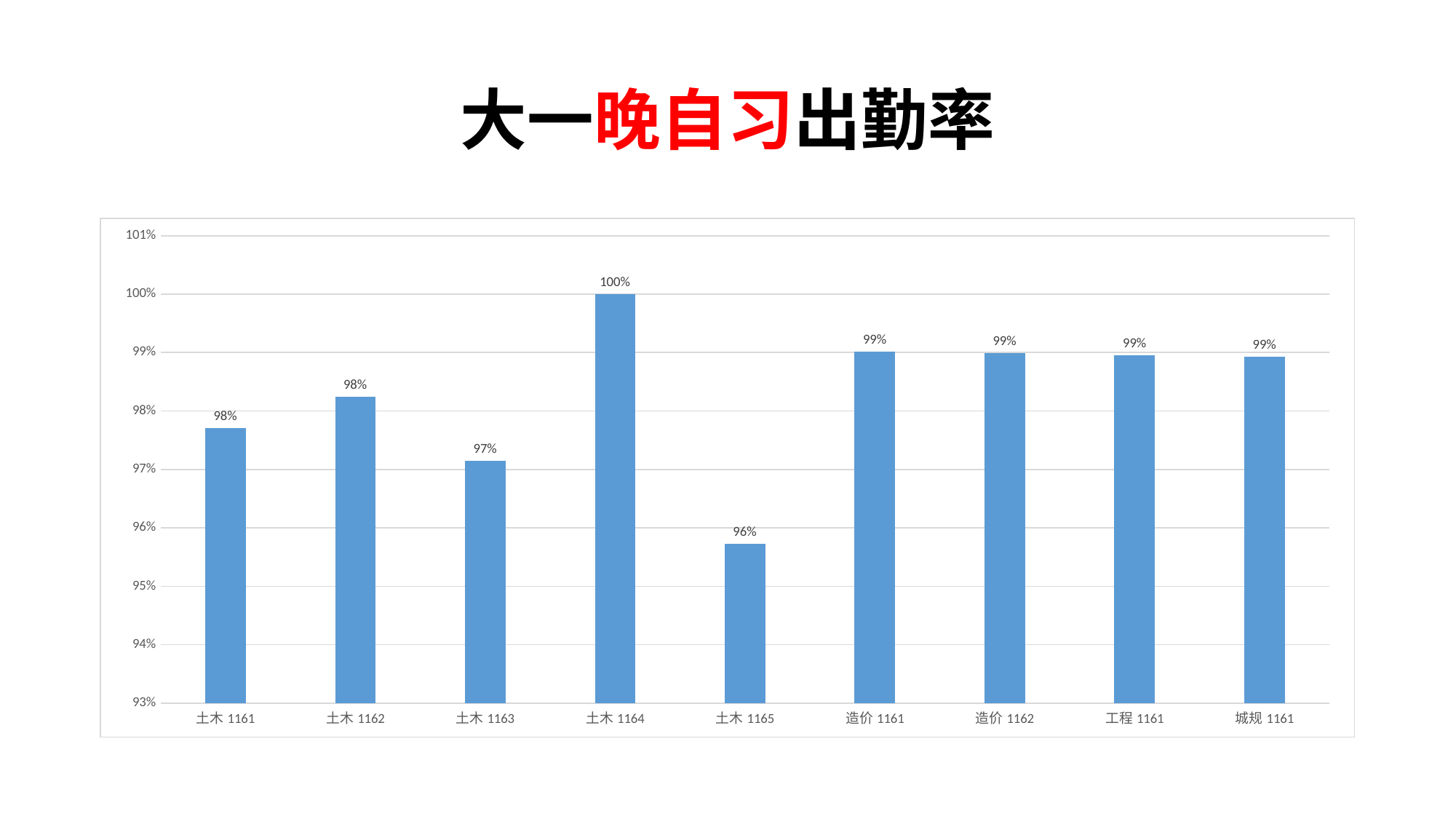
What is the value for 土木 1163? 97% How many categories are shown on the x axis? 9 Is the value for 土木 1165 greater or less than 97%? less What is the value for 造价 1162? 99% What is the difference between the values for 土木 1164 and 土木 1165? 4% What is the value for 土木 1164? 100% Which category has the lowest value? 土木 1165 What is the value for 土木 1165? 96% What kind of chart is shown on the slide? bar chart Which is larger, the value for 土木 1163 or the value for 造价 1161? 造价 1161 Which category has the highest value? 土木 1164 What is the title of the slide? 大一晚自习出勤率